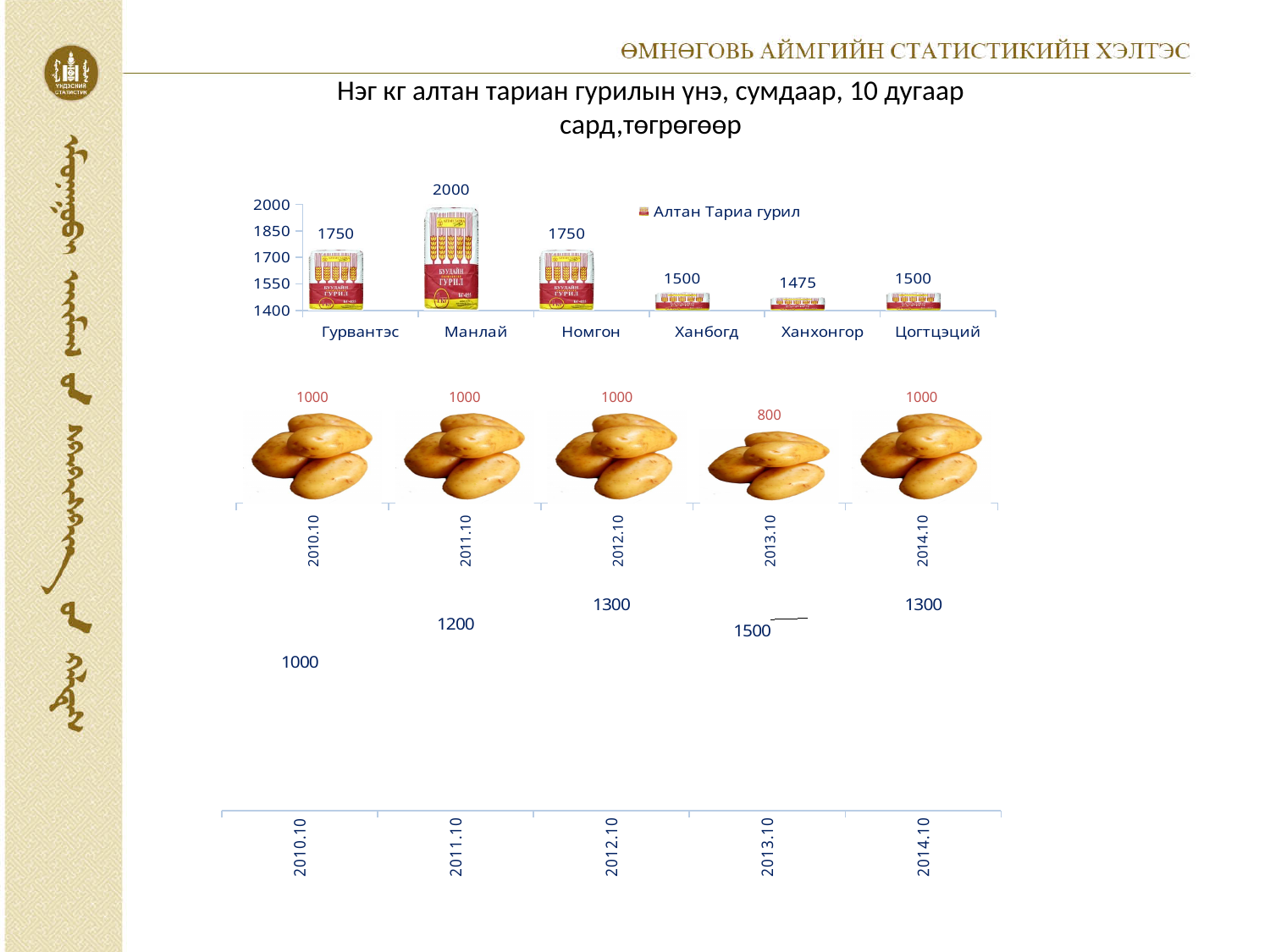
In the middle chart with the potato pictures, which year has the lowest value? 2013.10 In the top chart (Нэг кг алтан тариан гурилын үнэ), what series name does the legend show? Алтан Тариа гурил In the top chart (Нэг кг алтан тариан гурилын үнэ), what is the value for Ханхонгор? 1475 In the bottom chart, what is the value for 2013.10? 1500 In the top chart (Нэг кг алтан тариан гурилын үнэ), what is the difference between the values for Манлай and Гурвантэс? 250 In the middle chart with the potato pictures, what is the value for 2013.10? 800 In the bottom chart, what is the difference between the values for 2013.10 and 2010.10? 500 In the top chart (Нэг кг алтан тариан гурилын үнэ), what is the value for Манлай? 2000 In the top chart (Нэг кг алтан тариан гурилын үнэ), which category has the highest value? Манлай In the top chart (Нэг кг алтан тариан гурилын үнэ), which category has the lowest value? Ханхонгор In the top chart (Нэг кг алтан тариан гурилын үнэ), how many categories are shown on the x axis? 6 In the top chart (Нэг кг алтан тариан гурилын үнэ), which is larger, the value for Номгон or the value for Ханбогд? Номгон